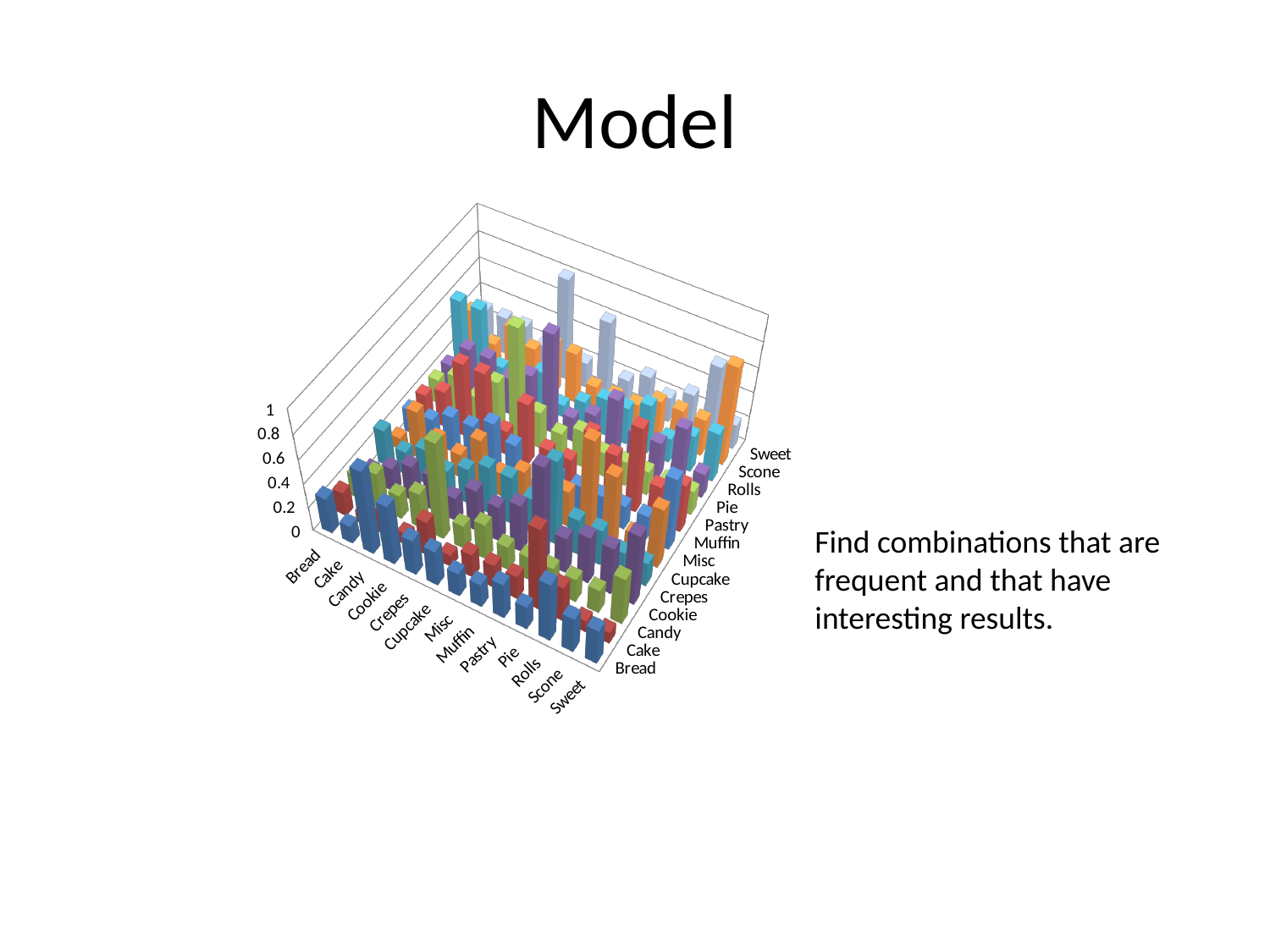
How many categories are labelled along the front (horizontal) axis of the chart? 13 What is the highest value shown on the vertical axis of the chart? 1 What is the interval between tick marks on the vertical axis of the chart? 0.2 What kind of chart is shown on the slide? 3D bar chart What is the title of the slide containing the chart? Model Does the chart display a legend? No Which category label is at the top of the depth axis on the right side of the chart? Sweet What is the lowest value shown on the vertical axis of the chart? 0 Which category label comes immediately after Cupcake on the front axis of the chart? Misc How many categories are labelled along the depth axis on the right side of the chart? 13 What is the first category label on the front axis of the chart? Bread